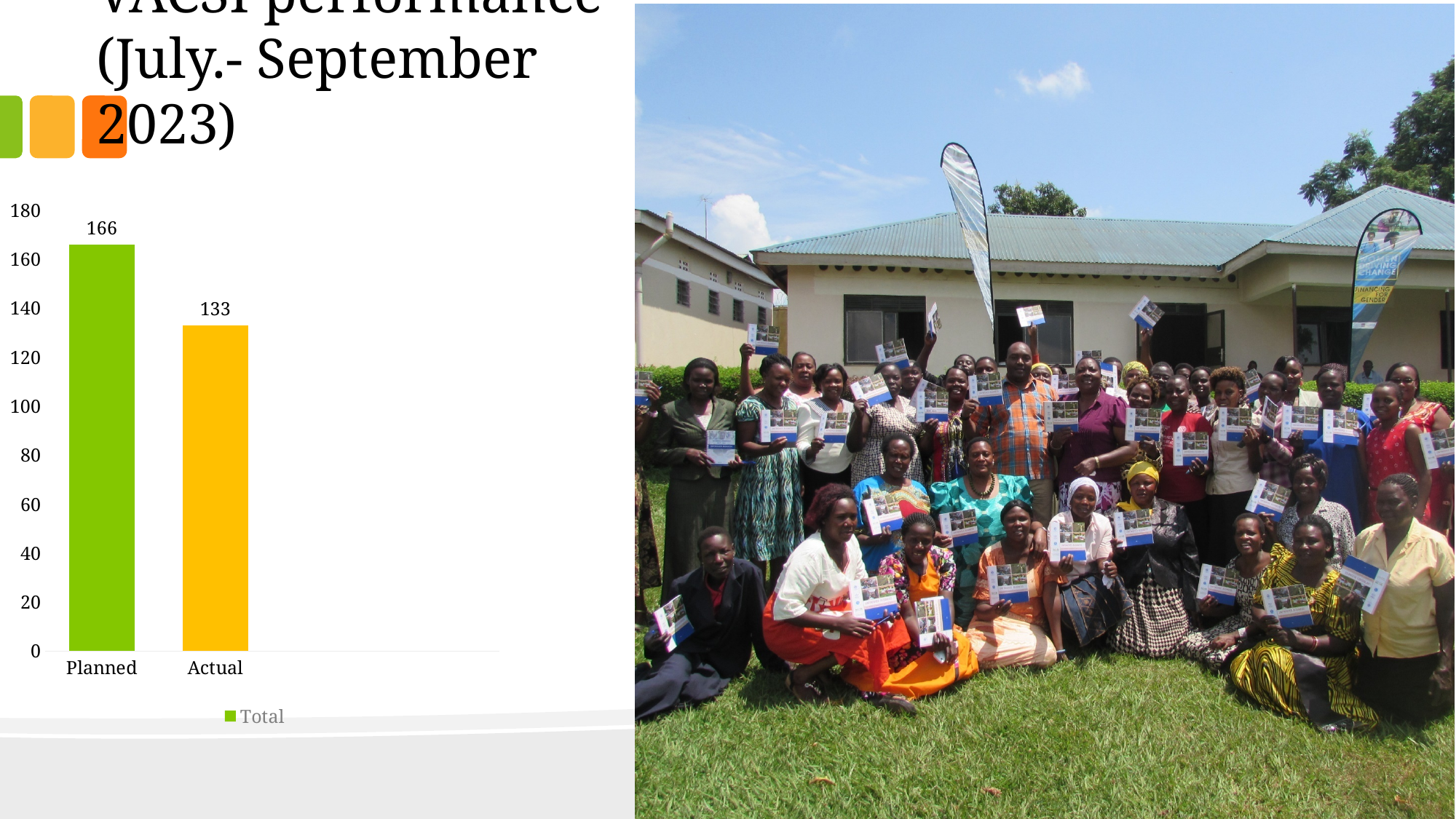
Which is larger, the Planned value or the Actual value? Planned How many categories are shown on the x axis? 2 What is the value for Planned? 166 What is the value for Actual? 133 Which category has the highest value? Planned How many series does the legend list? 1 What is the name of the series in the legend? Total Is the value for Actual greater or less than 140? less What is the difference between the Planned and Actual values? 33 What kind of chart is shown? bar chart Is the value for Planned greater or less than 160? greater Which category has the lowest value? Actual